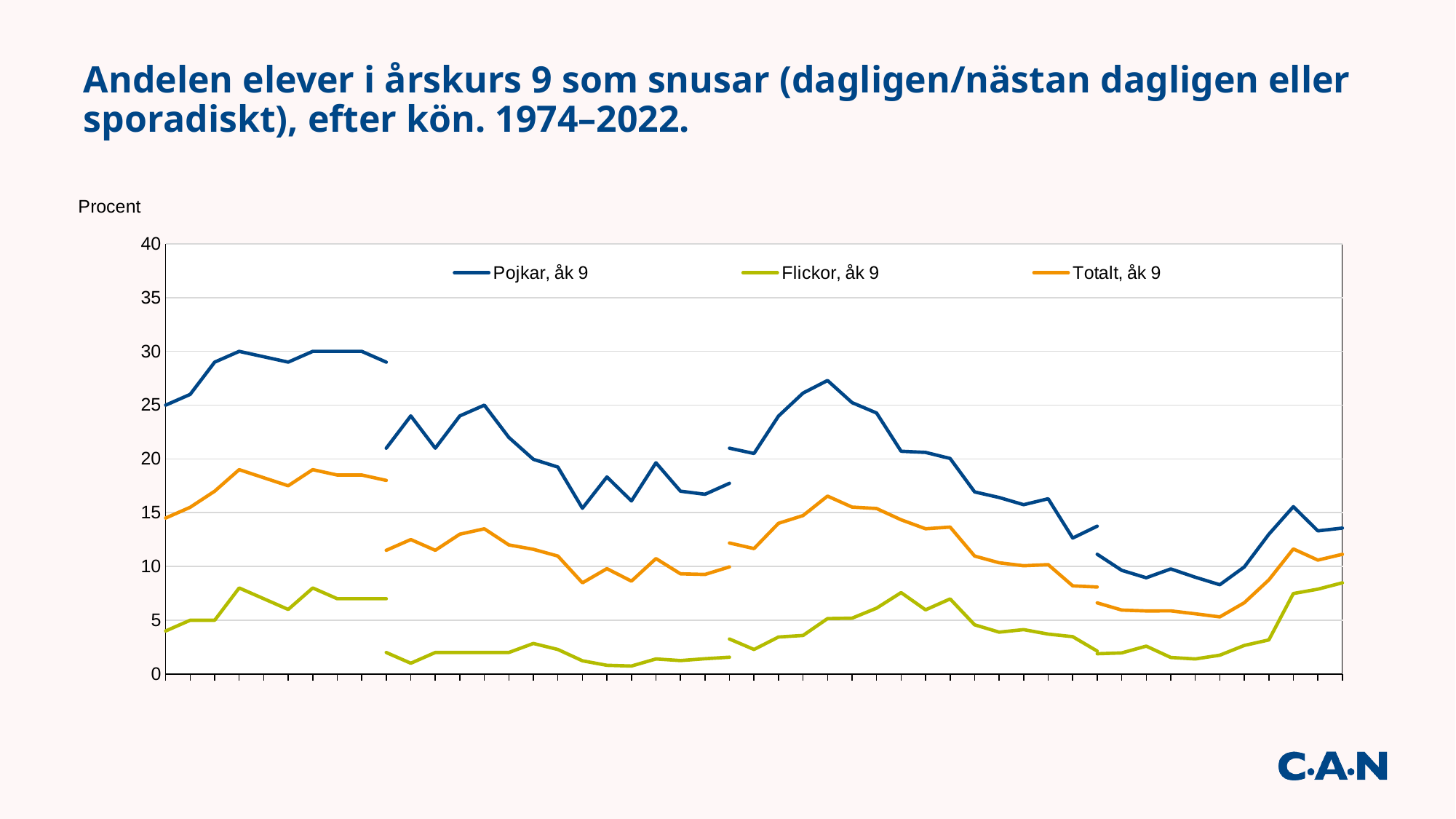
Comparing the start and the end of the chart, does the Pojkar, åk 9 line overall rise or fall? fall Which series has the highest values throughout the chart? Pojkar, åk 9 Is the highest value reached by Totalt, åk 9 greater or less than 15? greater Is the highest value reached by Pojkar, åk 9 greater or less than 35? less What is the label on the vertical axis? Procent Is the value for Pojkar, åk 9 at the start of the chart greater or less than 20? greater How many series does the legend list? 3 Which series is higher, Pojkar, åk 9 or Flickor, åk 9? Pojkar, åk 9 What kind of chart is shown on the slide? Line chart Which series has the lowest values throughout the chart? Flickor, åk 9 What period does the chart title say the data covers? 1974–2022